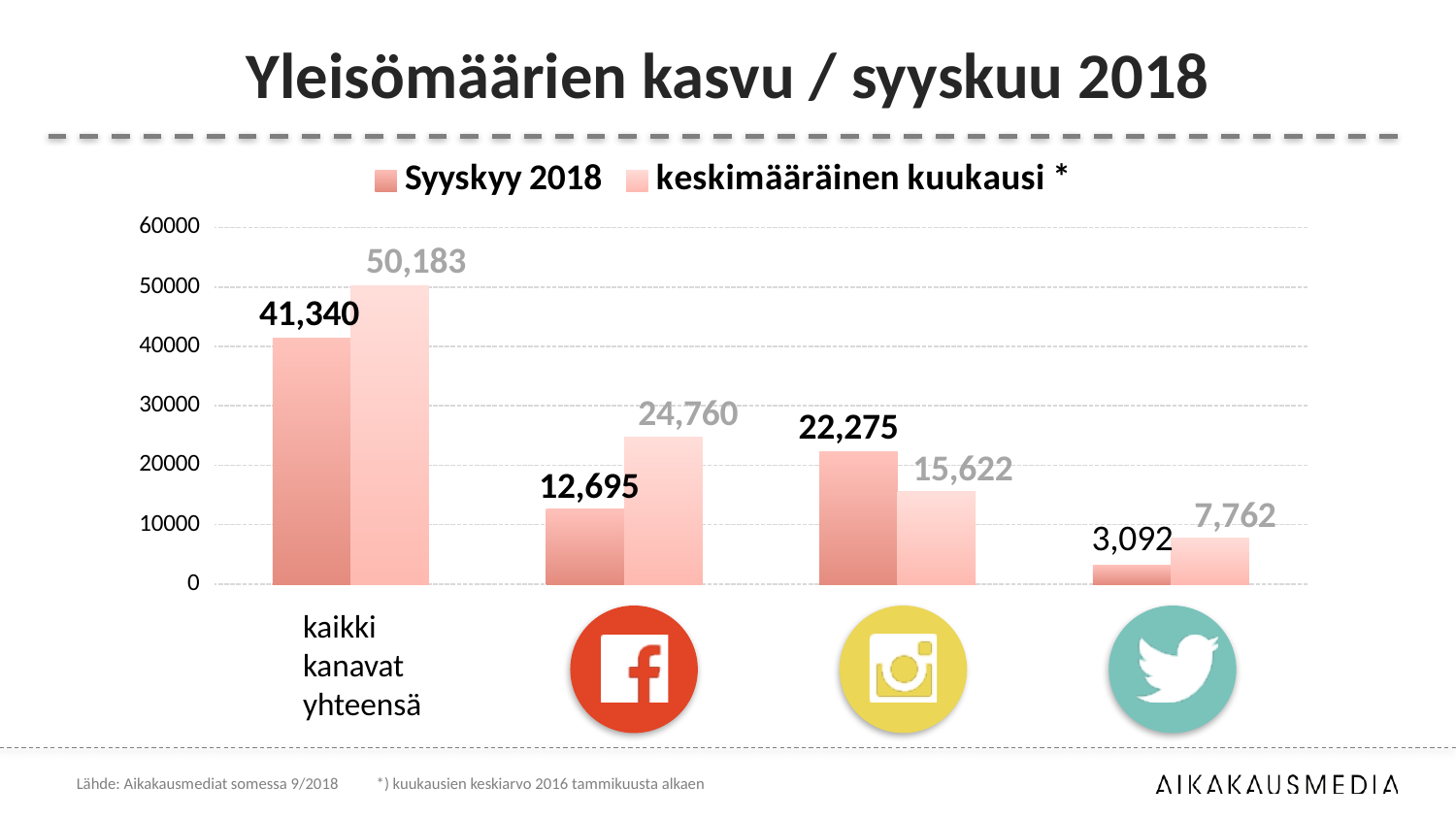
Which category has the lowest Syyskyy 2018 value? Twitter What is the Syyskyy 2018 value for the Twitter category? 3,092 What is the difference between the keskimääräinen kuukausi value and the Syyskyy 2018 value for Facebook? 12,065 What is the Syyskyy 2018 value for the Facebook category? 12,695 How many categories are shown on the x axis? 4 What is the keskimääräinen kuukausi value for the Instagram category? 15,622 What is the value for "kaikki kanavat yhteensä" in the keskimääräinen kuukausi series? 50,183 What type of chart is shown on the slide? Bar chart What is the value for "kaikki kanavat yhteensä" in the Syyskyy 2018 series? 41,340 For Instagram, which is larger: the Syyskyy 2018 value or the keskimääräinen kuukausi value? Syyskyy 2018 How many series does the legend list? 2 Which category has the highest keskimääräinen kuukausi value? kaikki kanavat yhteensä